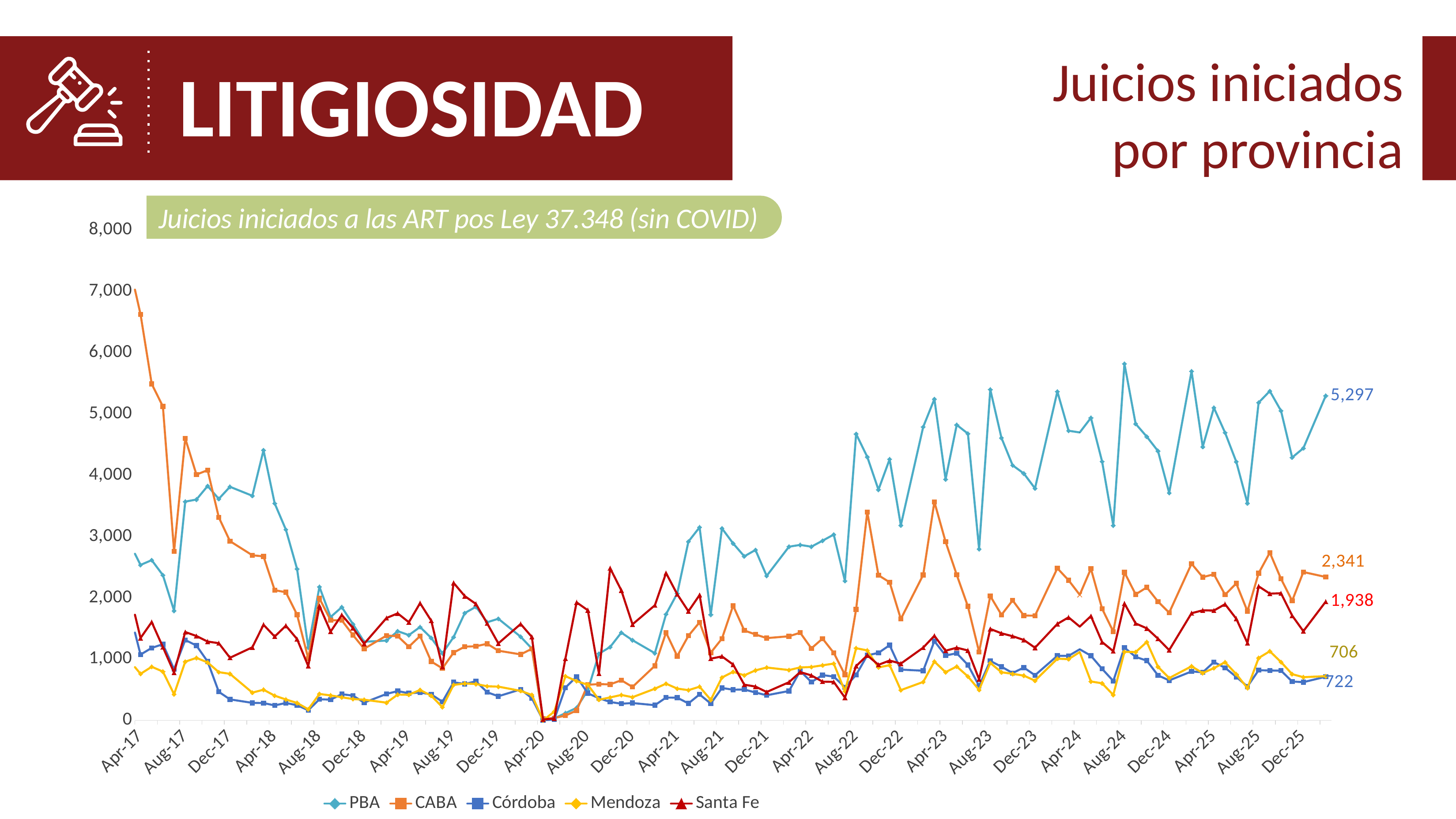
Is the value for CABA at Apr-17 greater or less than 6,000? greater Is the value for PBA at Apr-20 greater or less than 1,000? less How many series does the legend list? 5 Which province has the highest value at the end of the series? PBA What is the difference between the final labelled values of PBA and CABA? 2,956 What is the subtitle shown in the green box above the chart? Juicios iniciados a las ART pos Ley 37.348 (sin COVID) What is the difference between the final labelled values of CABA and Santa Fe? 403 What is the final labelled value for CABA at the right end of the chart? 2,341 At the end of the series, which is larger: CABA or Santa Fe? CABA What is the final labelled value for Santa Fe at the right end of the chart? 1,938 What is the final labelled value for PBA at the right end of the chart? 5,297 What kind of chart is shown on the slide? line chart